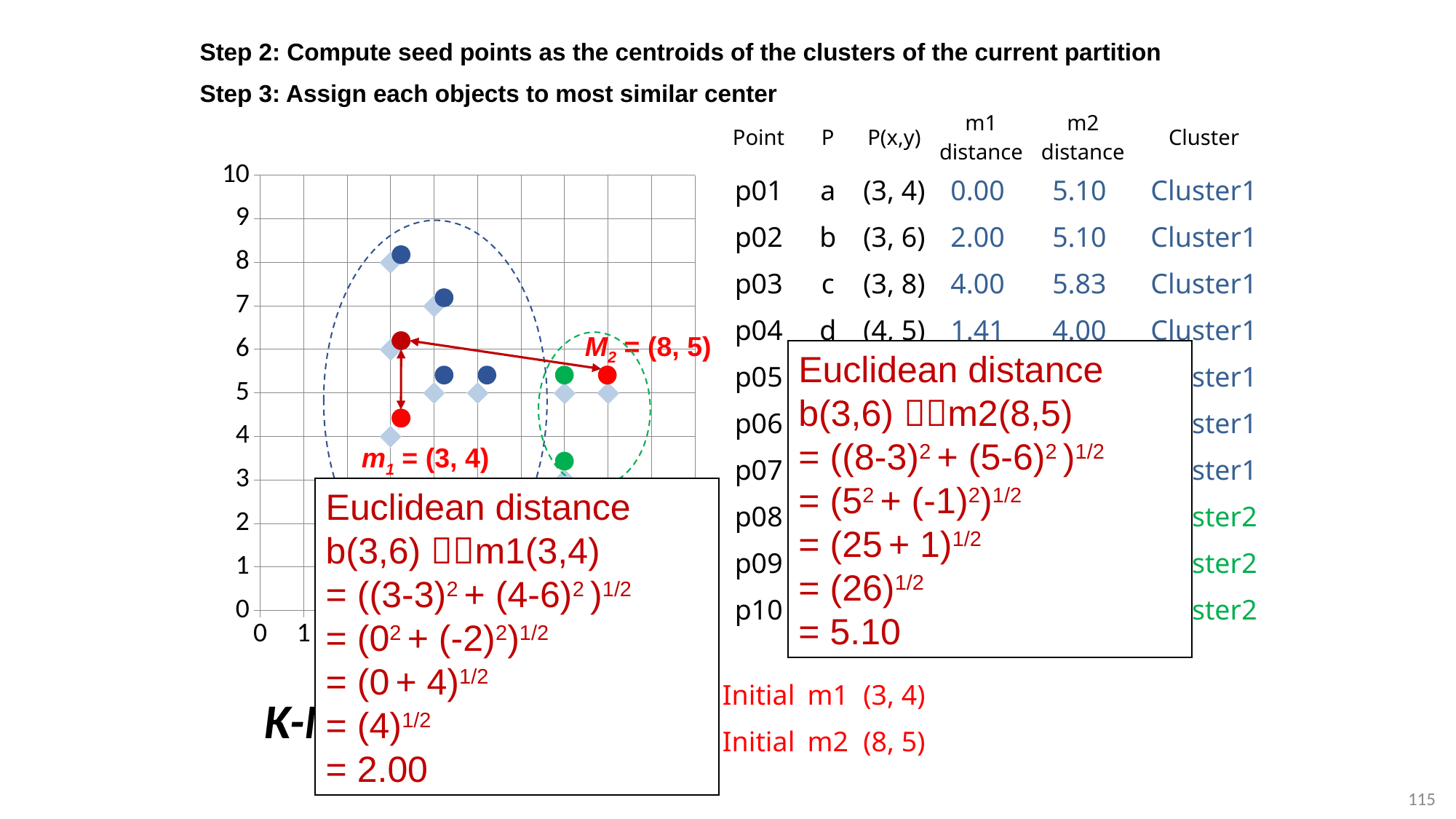
How many green circle points are visible on the chart? 2 What colour is the point labeled M2 on the chart? red Is the y value of the highest blue circle on the chart greater or less than 7? greater Is the y value of the lower green circle on the chart greater or less than 4? less What kind of chart is shown on the slide? scatter chart What coordinates are labeled for M2 on the chart? (8, 5) What is the highest tick value shown on the chart's y axis? 10 Which labeled centroid has the larger y coordinate, m1 or M2? M2 Is the x coordinate of the point labeled M2 greater or less than 6? greater What coordinates are labeled for m1 on the chart? (3, 4) What is the difference between the x coordinate of M2 and the x coordinate of m1? 5